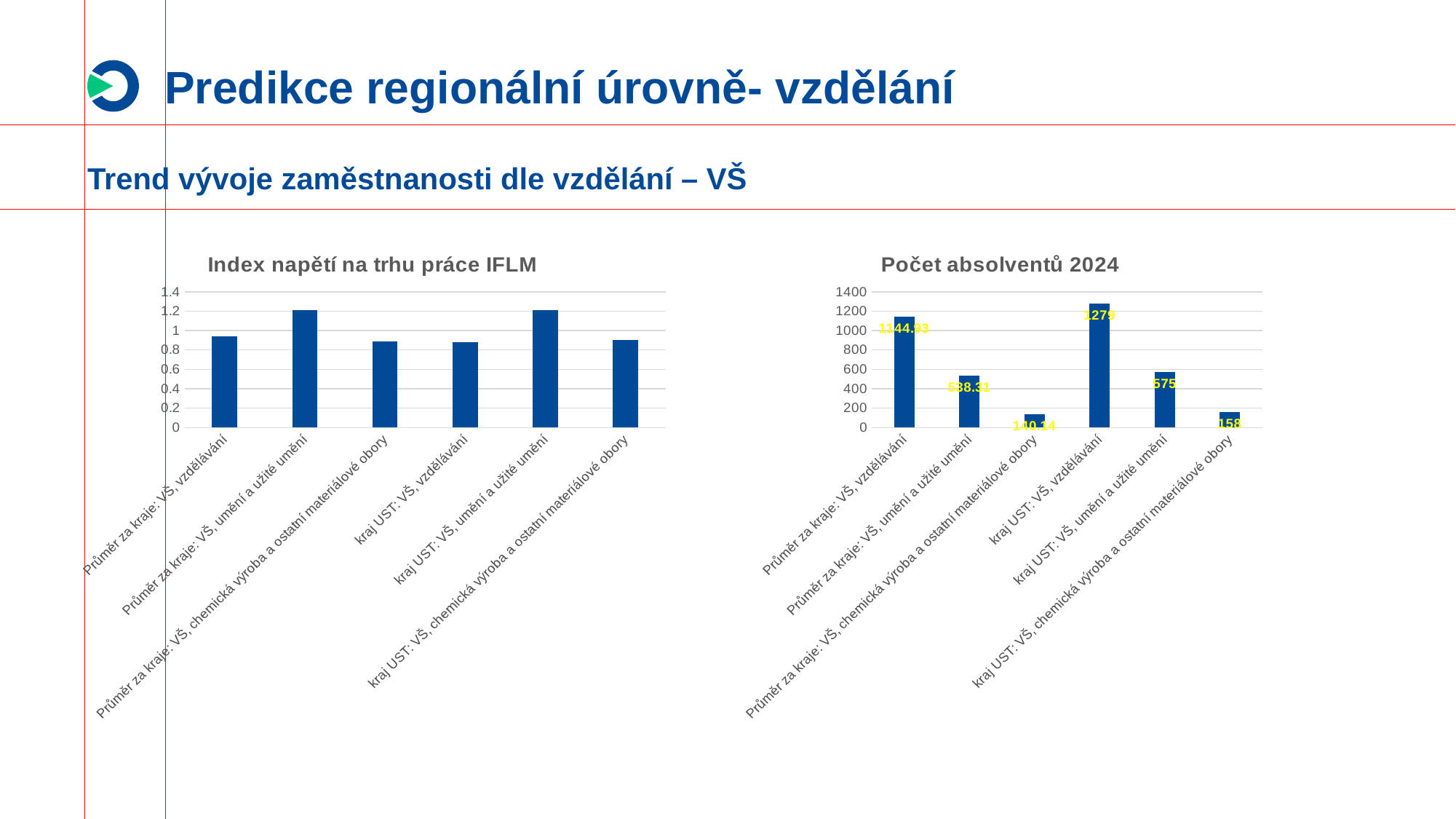
In the chart titled "Počet absolventů 2024", which category has the lowest value? Průměr za kraje: VŠ, chemická výroba a ostatní materiálové obory In the chart titled "Počet absolventů 2024", what is the value for "kraj UST: VŠ, vzdělávání"? 1279 In the chart titled "Počet absolventů 2024", which category has the highest value? kraj UST: VŠ, vzdělávání In the chart titled "Index napětí na trhu práce IFLM", is the value for "Průměr za kraje: VŠ, umění a užité umění" greater or less than 1? greater In the chart titled "Počet absolventů 2024", what is the difference between the values for "kraj UST: VŠ, vzdělávání" and "Průměr za kraje: VŠ, vzdělávání"? 134.07 In the chart titled "Počet absolventů 2024", which is larger: the value for "kraj UST: VŠ, umění a užité umění" or the value for "kraj UST: VŠ, chemická výroba a ostatní materiálové obory"? kraj UST: VŠ, umění a užité umění In the chart titled "Index napětí na trhu práce IFLM", which is larger: the value for "kraj UST: VŠ, umění a užité umění" or the value for "kraj UST: VŠ, vzdělávání"? kraj UST: VŠ, umění a užité umění In the chart titled "Počet absolventů 2024", what is the difference between the values for "kraj UST: VŠ, umění a užité umění" and "Průměr za kraje: VŠ, umění a užité umění"? 36.69 In the chart titled "Počet absolventů 2024", what is the value for "kraj UST: VŠ, chemická výroba a ostatní materiálové obory"? 158 How many categories are shown in the chart titled "Index napětí na trhu práce IFLM"? 6 In the chart titled "Index napětí na trhu práce IFLM", is the value for "kraj UST: VŠ, vzdělávání" greater or less than 1? less In the chart titled "Počet absolventů 2024", what is the value for "Průměr za kraje: VŠ, umění a užité umění"? 538.31